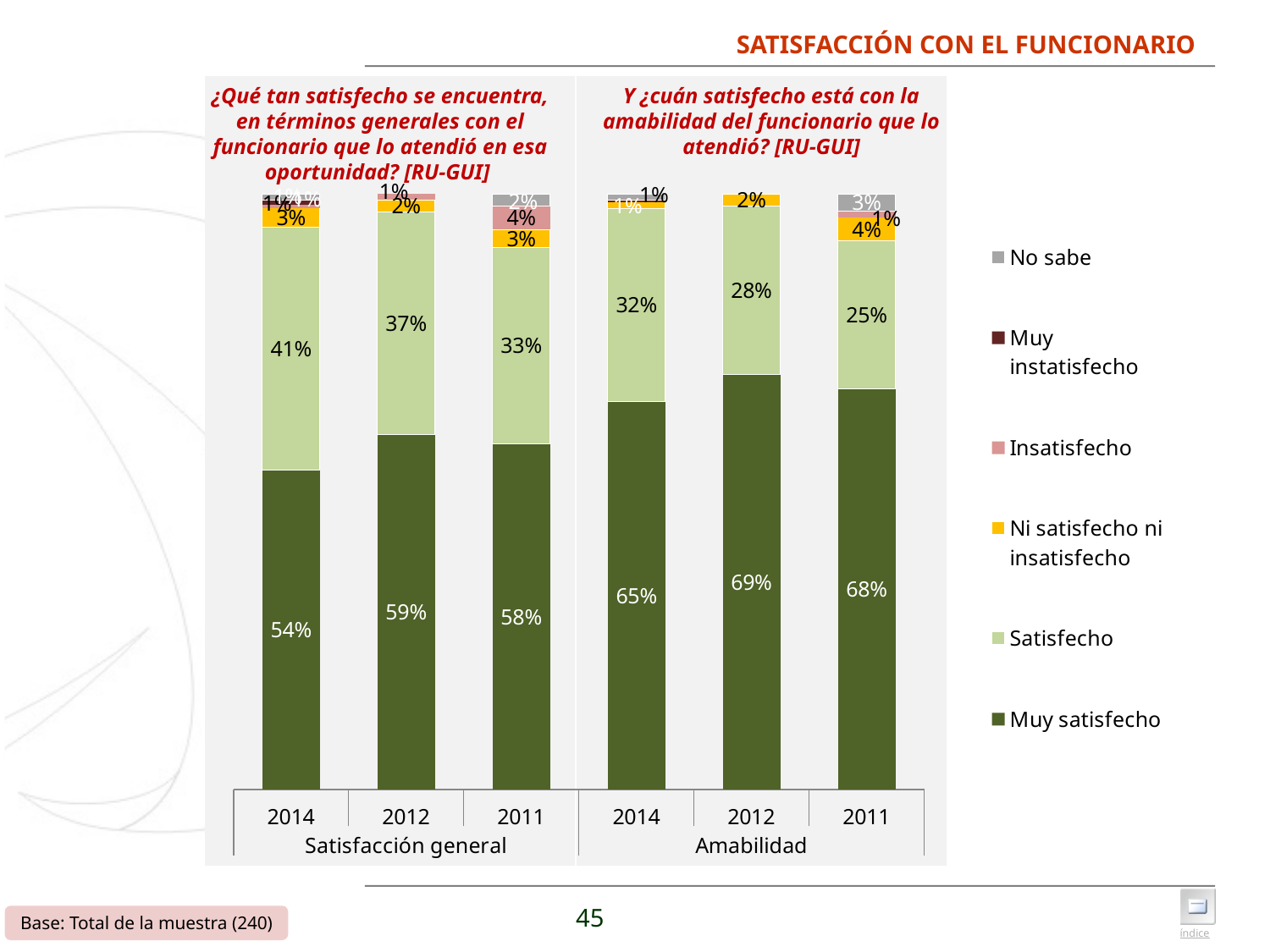
Which bar has the lowest Satisfecho value? Amabilidad 2011 What kind of chart is shown on the slide? stacked bar chart What is the Satisfecho value for Amabilidad in 2012? 28% What is the Muy satisfecho value for Satisfacción general in 2014? 54% What is the Muy satisfecho value for Amabilidad in 2011? 68% What is the difference between the Muy satisfecho values for Satisfacción general in 2012 and 2014? 5% Which is larger: the Satisfecho value for Satisfacción general 2014 or for Amabilidad 2014? Satisfacción general 2014 How many bars are plotted in the chart? 6 Which legend entry is shown in dark green? Muy satisfecho What is the Insatisfecho value for Satisfacción general in 2011? 4% Which bar has the highest Muy satisfecho value? Amabilidad 2012 How many series does the legend list? 6